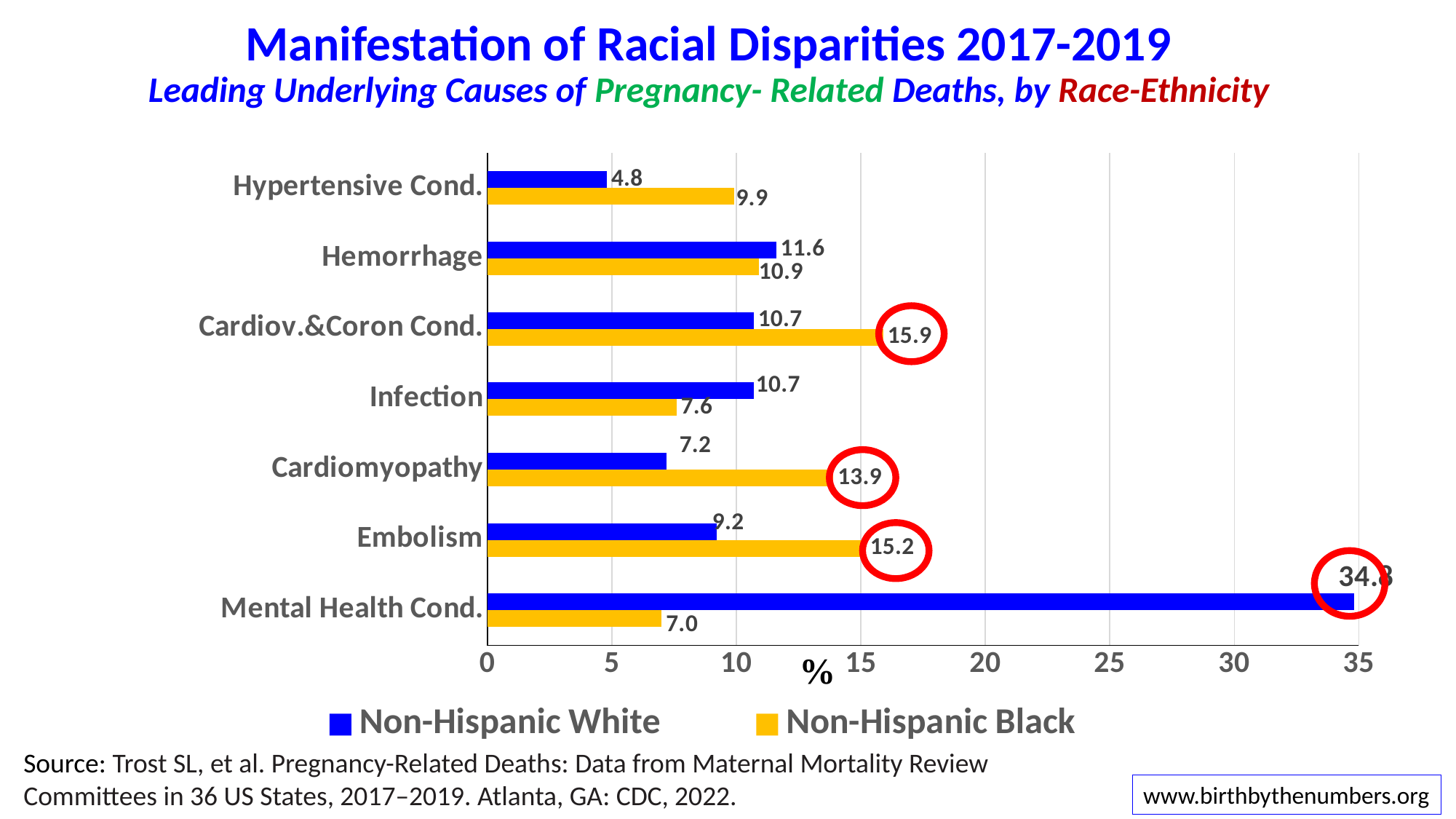
How many series does the legend list? 2 Which cause has the highest Non-Hispanic White value? Mental Health Cond. What is the Non-Hispanic Black value for Hypertensive Cond.? 9.9 What type of chart is shown on the slide? bar chart What is the difference between the Non-Hispanic Black and Non-Hispanic White values for Cardiomyopathy? 6.7 Which colour represents Non-Hispanic Black in the chart? yellow What is the Non-Hispanic White value for Mental Health Cond.? 34.8 Is the Non-Hispanic Black value for Embolism greater or less than 10? greater Which cause has the lowest Non-Hispanic Black value? Mental Health Cond. For Infection, which group has the larger value, Non-Hispanic White or Non-Hispanic Black? Non-Hispanic White What is the Non-Hispanic Black value for Cardiov.&Coron Cond.? 15.9 How many causes of death are listed on the chart? 7